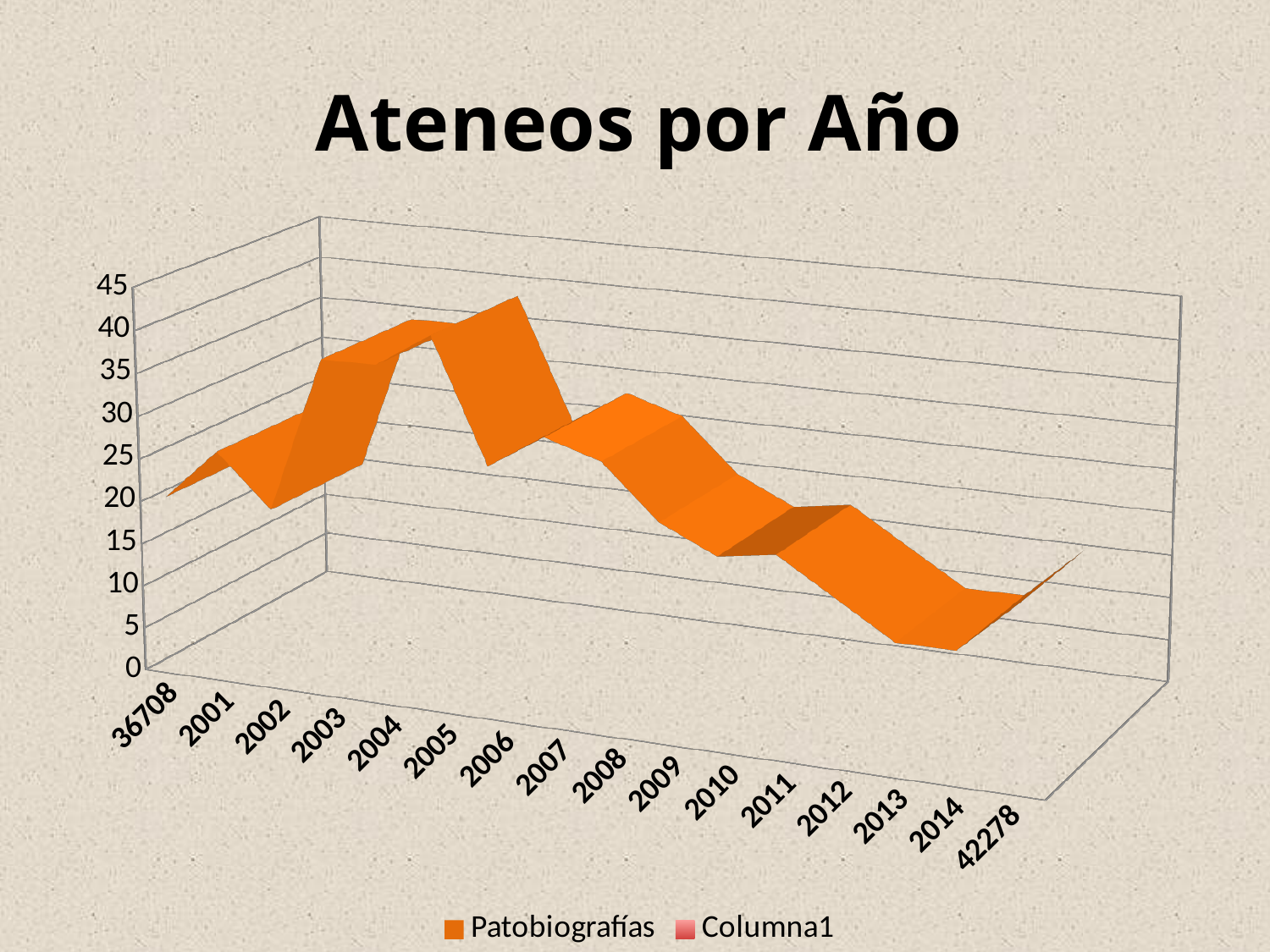
Do the values rise or fall from 2013 to the last category, 42278? rise How many categories are shown along the x axis? 16 What is the highest value shown on the vertical axis? 45 What is the title of the chart? Ateneos por Año Is the highest value plotted on the chart greater or less than 30? greater What are the two series names shown in the legend? Patobiografías and Columna1 Do the values rise or fall from 2002 to 2004? rise How many series does the legend list? 2 What kind of chart is shown on the slide? 3D line chart Do the values generally rise or fall from 2006 to 2013? fall